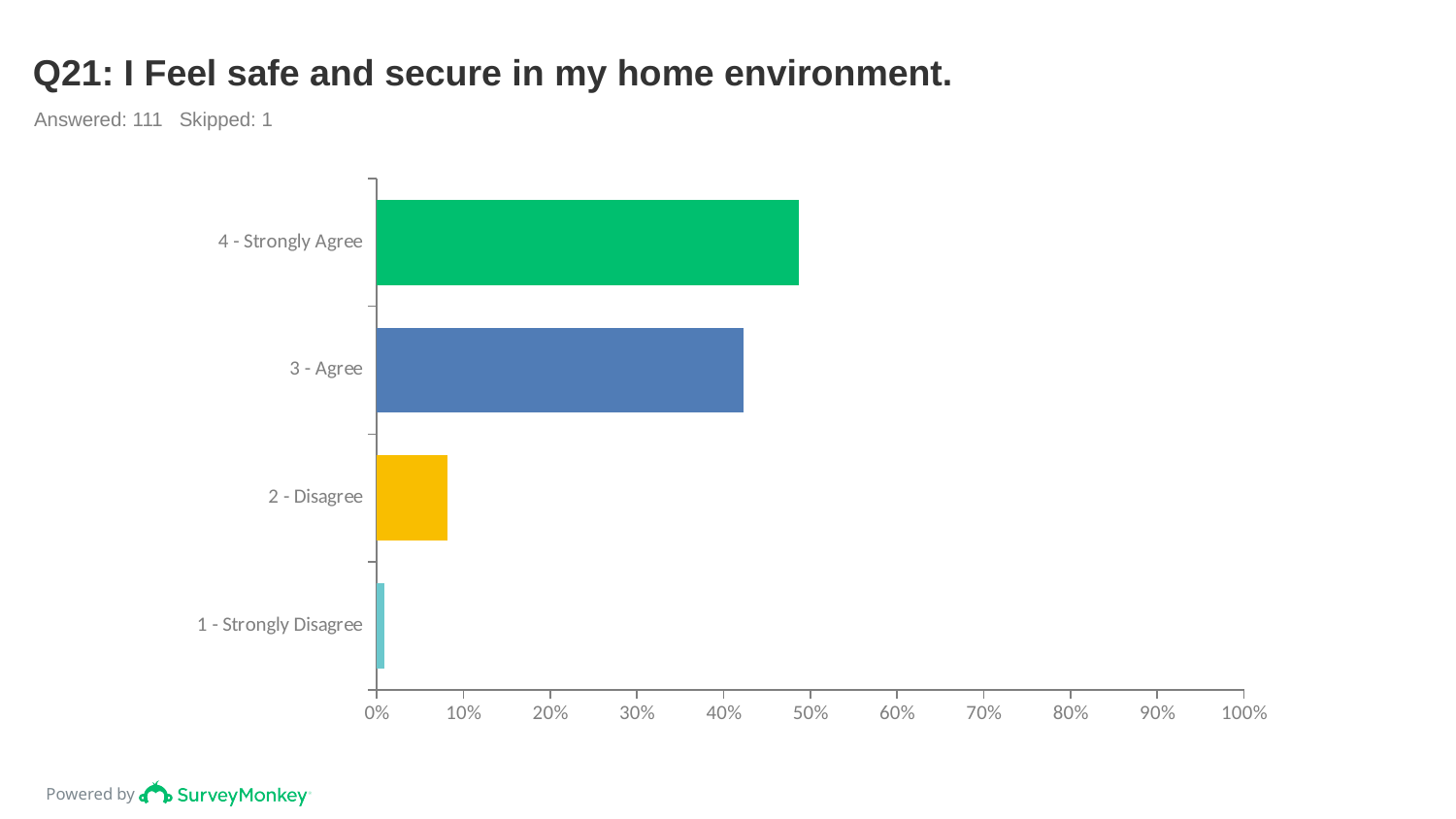
Which is larger, the value for 3 - Agree or the value for 2 - Disagree? 3 - Agree Which category has the lowest value? 1 - Strongly Disagree Is the value for 3 - Agree greater or less than 50%? less What is the title of the chart? Q21: I Feel safe and secure in my home environment. What type of chart is shown on the slide? bar chart Which is larger, the value for 4 - Strongly Agree or the value for 3 - Agree? 4 - Strongly Agree Is the value for 4 - Strongly Agree greater or less than 40%? greater Which category has the highest value? 4 - Strongly Agree How many categories are shown in the chart? 4 Is the value for 2 - Disagree greater or less than 10%? less How many respondents answered the question according to the slide? 111